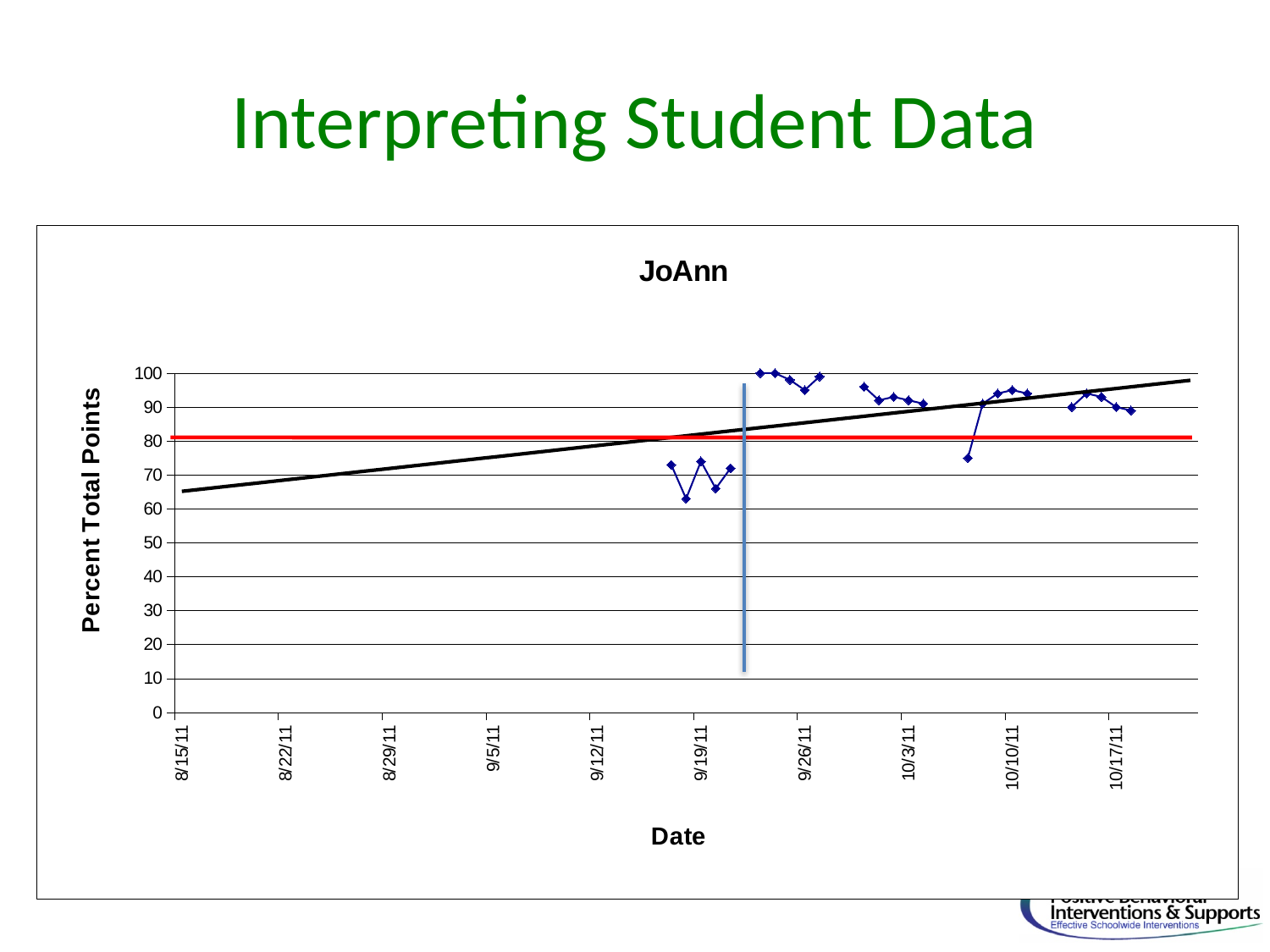
What kind of chart is shown on the slide? line chart What is the label on the vertical axis of the chart? Percent Total Points Are the data points plotted just after the blue vertical line (around 9/26/11) greater or less than 90? greater Is the red horizontal line above or below the 70 gridline? above Is the highest plotted data point greater or less than 90? greater What is the highest value shown on the vertical axis of the chart? 100 Does the black straight line rise or fall from left to right across the chart? rises Which is larger: the first plotted data point before 9/19/11 or the first plotted data point after the blue vertical line? the first point after the blue vertical line What is the title of the chart? JoAnn